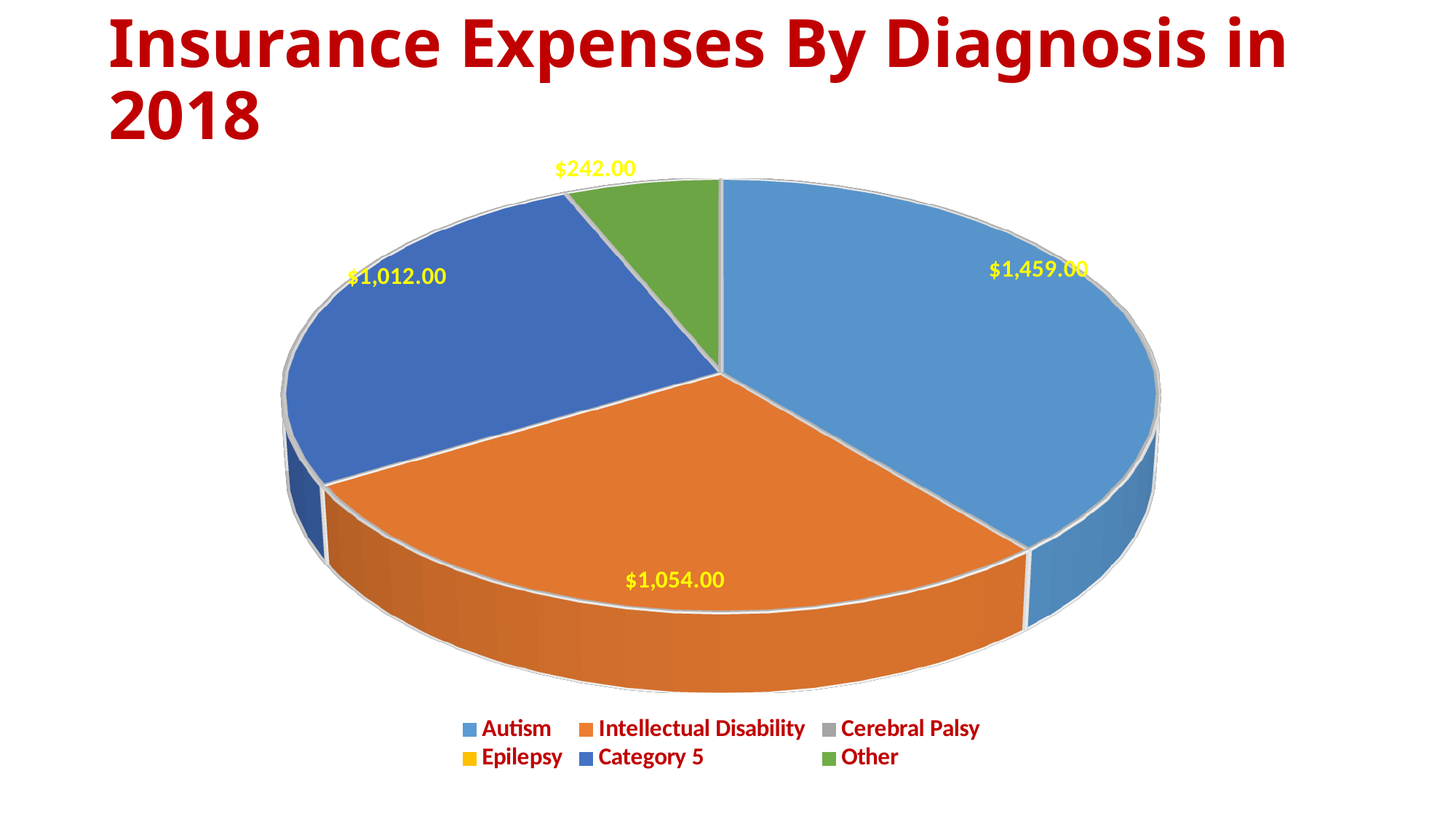
Which diagnosis has the largest insurance expense? Autism What is the insurance expense for Autism? $1,459.00 How many entries does the legend list? 6 How many slices with data labels are shown in the pie chart? 4 Which labelled slice has the smallest insurance expense? Other What type of chart is shown on the slide? Pie chart Which is larger, the expense for Intellectual Disability or for Category 5? Intellectual Disability What is the difference between the Autism expense and the Intellectual Disability expense? $405.00 What is the difference between the Category 5 expense and the Other expense? $770.00 What is the insurance expense for Other? $242.00 What is the insurance expense for Intellectual Disability? $1,054.00 What is the insurance expense for Category 5? $1,012.00